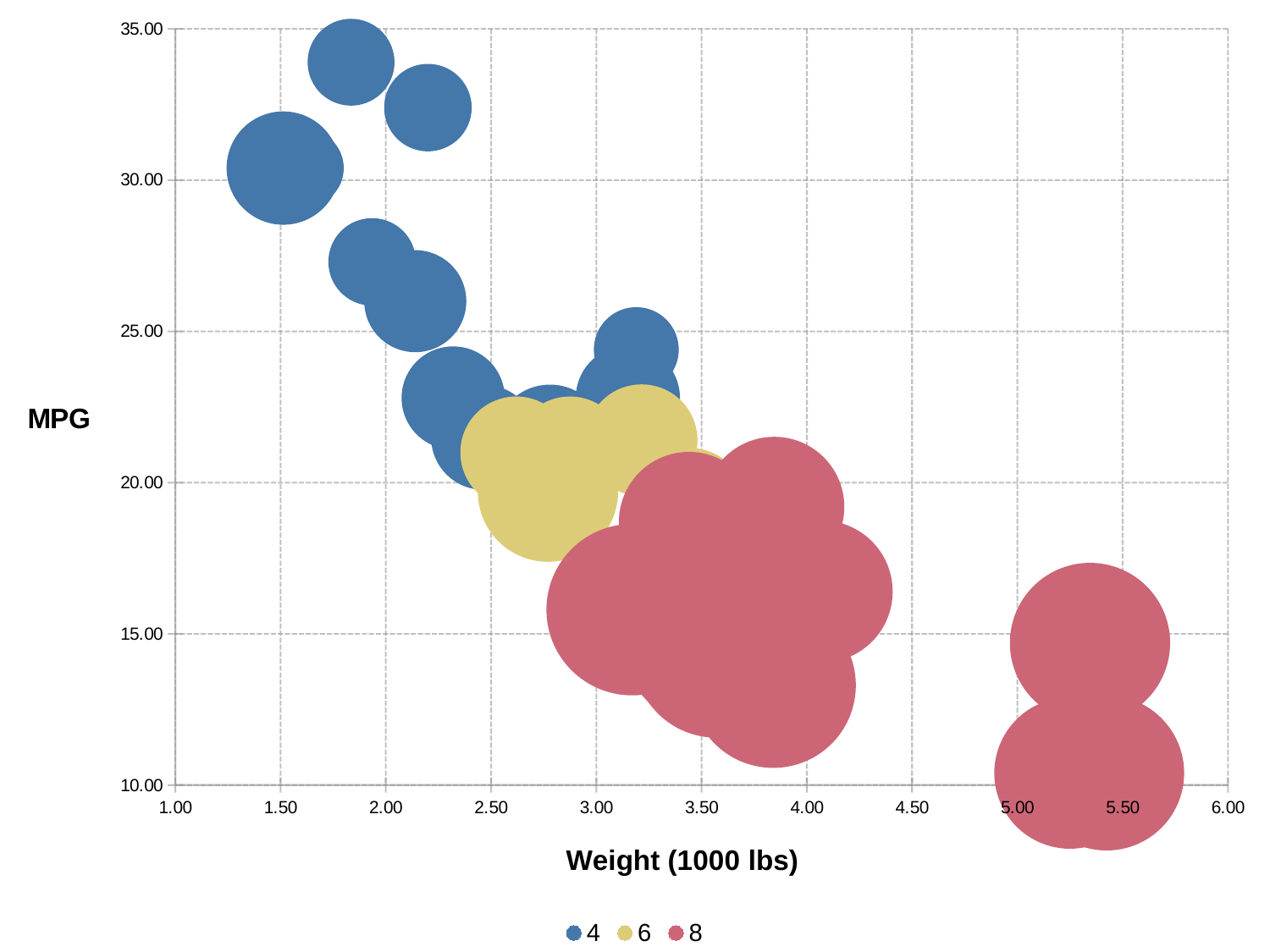
Are the yellow (series 6) bubbles above or below 25.00 MPG? below How many series does the legend list? 3 What are the series names listed in the legend? 4, 6, 8 Is the weight of the rightmost red (series 8) bubbles greater or less than 5.00? greater What is the title of the horizontal axis? Weight (1000 lbs) Which series has the bubbles with the greatest weight? 8 What kind of chart is shown on the slide? Bubble chart Which series has the bubbles with the highest MPG values? 4 Which series has the bubbles with the lowest MPG values? 8 As weight increases along the x axis, does MPG generally rise or fall? Fall Is the MPG of the highest blue (series 4) bubble greater or less than 30.00? greater Which series has higher MPG values overall, series 6 or series 8? 6